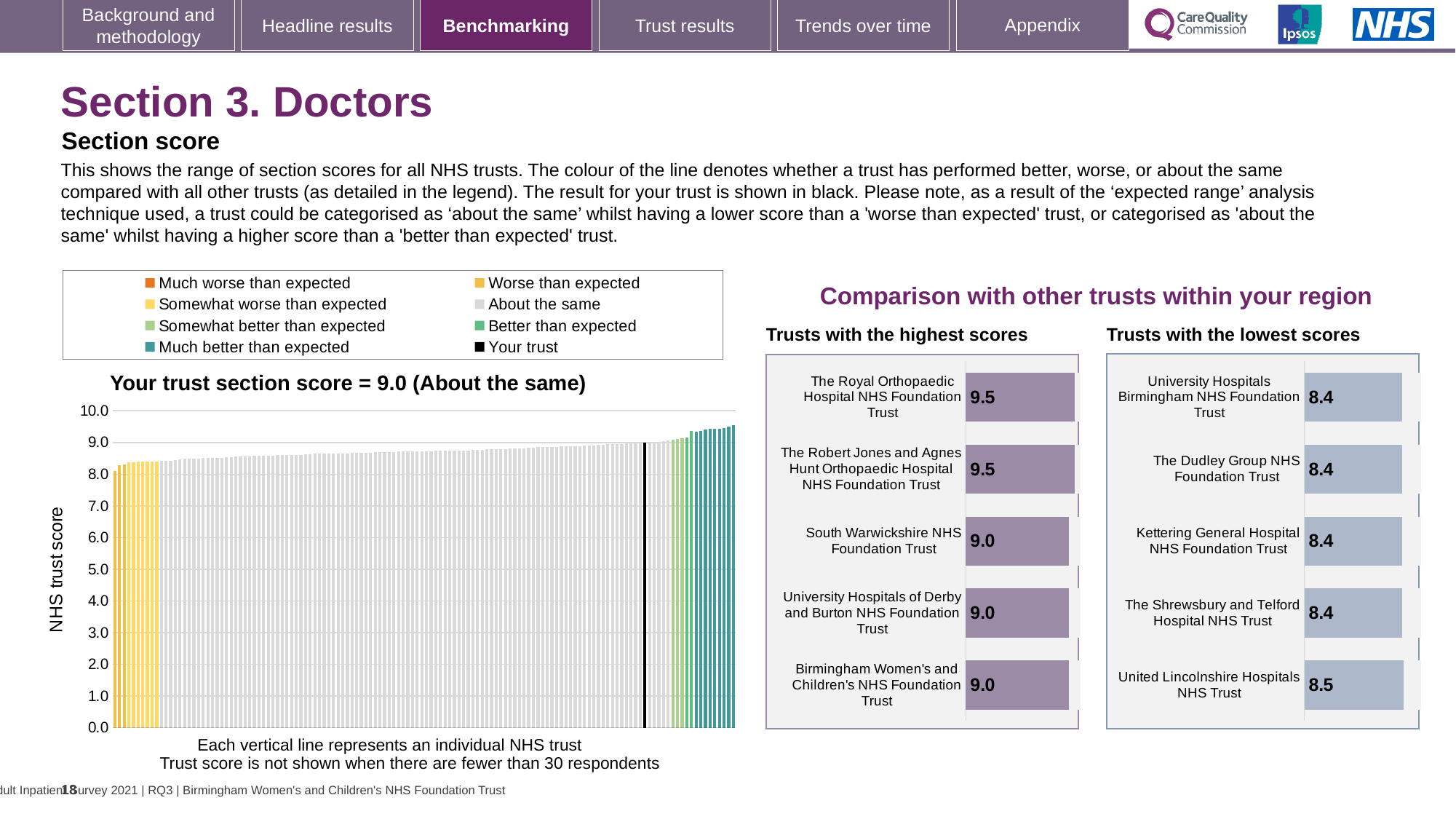
In the 'Trusts with the highest scores' chart, how many trusts are listed? 5 In the 'Trusts with the highest scores' chart, what is the difference between the score for The Royal Orthopaedic Hospital NHS Foundation Trust and the score for South Warwickshire NHS Foundation Trust? 0.5 What is the label on the vertical axis of the main chart on the left? NHS trust score What kind of chart is the main chart on the left showing all NHS trusts? Bar chart In the 'Trusts with the highest scores' chart, what is the score for The Royal Orthopaedic Hospital NHS Foundation Trust? 9.5 How many entries does the legend above the main chart on the left list? 8 In the 'Trusts with the lowest scores' chart, what is the score for The Dudley Group NHS Foundation Trust? 8.4 In the 'Trusts with the lowest scores' chart, which has the higher score: United Lincolnshire Hospitals NHS Trust or Kettering General Hospital NHS Foundation Trust? United Lincolnshire Hospitals NHS Trust In the 'Trusts with the lowest scores' chart, what is the score for United Lincolnshire Hospitals NHS Trust? 8.5 In the main chart on the left, do the trust scores rise or fall from left to right along the x axis? Rise In the main chart on the left, what is your trust's section score as stated in the chart title? 9.0 In the 'Trusts with the lowest scores' chart, how many trusts are listed? 5